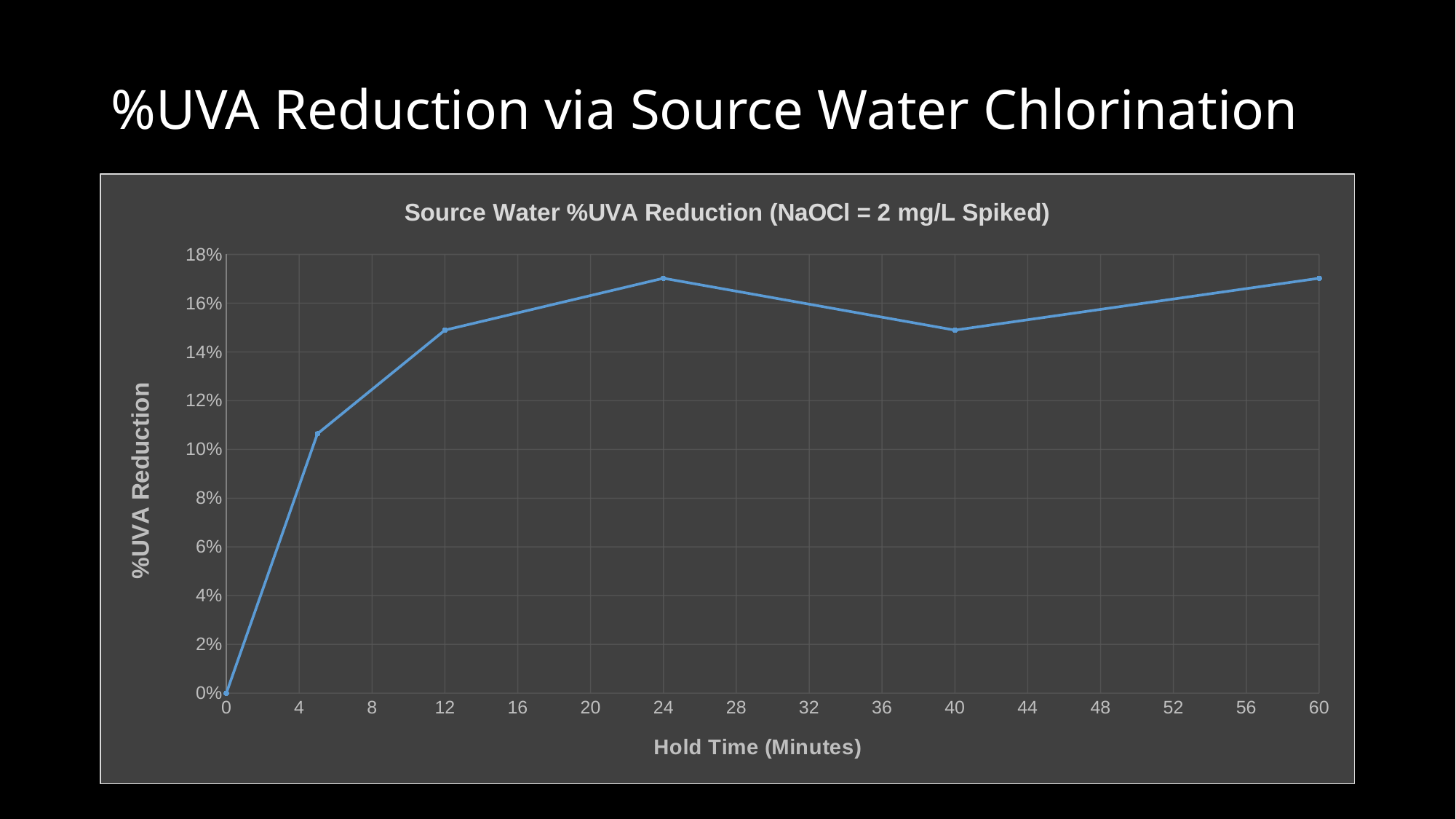
Is the %UVA reduction at a hold time of 60 minutes greater or less than 16%? greater Is the %UVA reduction at a hold time of 12 minutes greater or less than 14%? greater Does the %UVA reduction rise or fall between hold times of 0 and 24 minutes? rise What is the label of the x axis? Hold Time (Minutes) How many data points are plotted on the line? 6 Is the %UVA reduction at a hold time of 24 minutes greater or less than 16%? greater Which hold time has the higher %UVA reduction, 24 minutes or 40 minutes? 24 minutes What is the %UVA reduction at a hold time of 0 minutes? 0% What is the title of the chart? Source Water %UVA Reduction (NaOCl = 2 mg/L Spiked) What kind of chart is shown on the slide? line chart At which hold time is the %UVA reduction lowest? 0 minutes